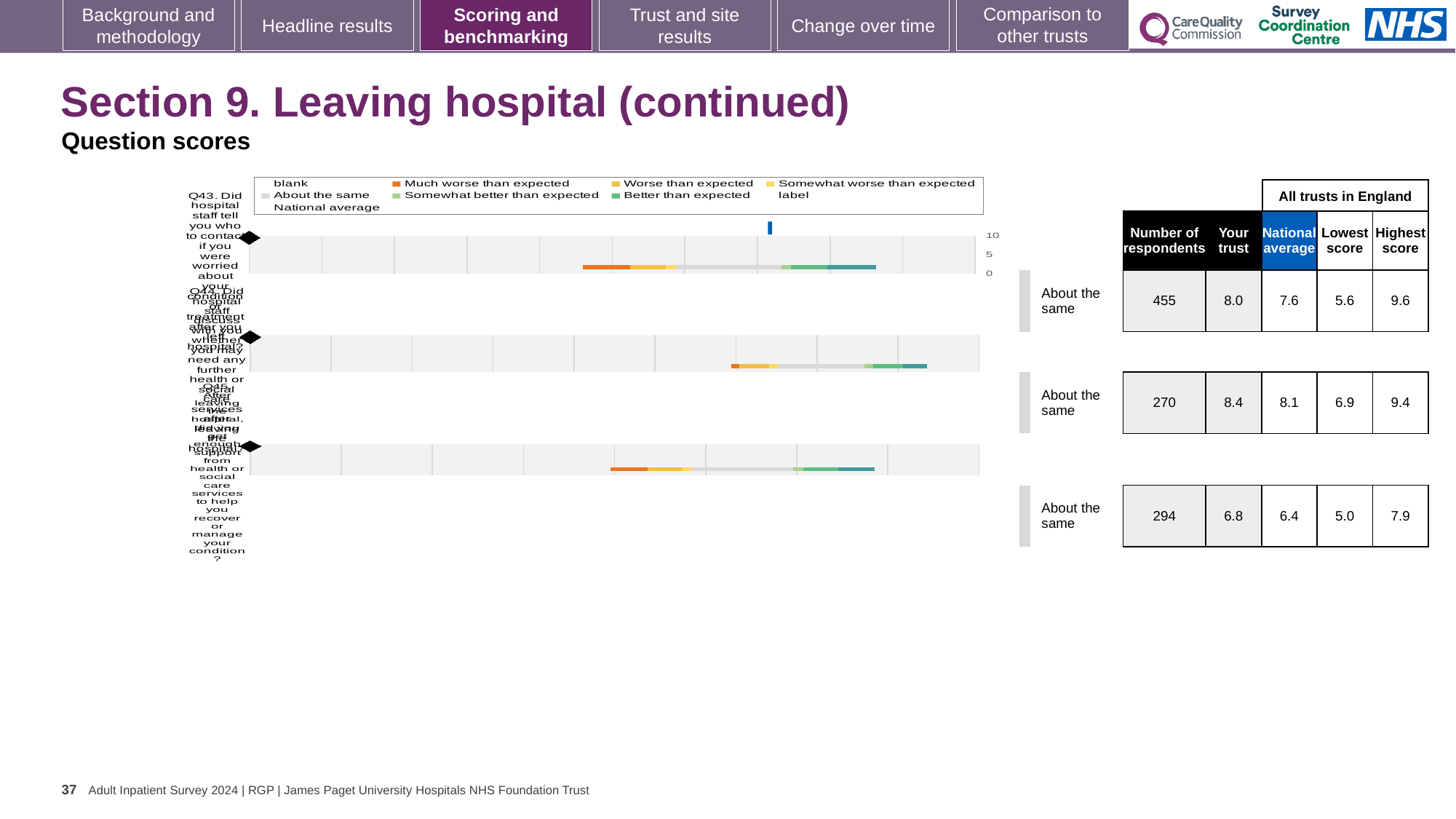
Which of the three charts has the lowest 'Lowest score' value? the bottom chart (Q45), 5.0 Which of the three charts has the highest 'Your trust' score? the middle chart (Q44), 8.4 For the middle chart (Q44), which is larger: the 'Your trust' score or the national average? Your trust For the top chart (Q43), what is the 'Your trust' score shown in the table? 8.0 What kind of chart is used to show the question scores on this slide? bar chart For the middle chart (Q44), what is the national average score? 8.1 For the top chart (Q43), what is the difference between the 'Your trust' score and the national average? 0.4 For the top chart (Q43), what is the highest score among all trusts in England? 9.6 How many question charts are shown on the slide? 3 What benchmark category is shown next to each of the three charts? About the same For the bottom chart (Q45), how many respondents are listed? 294 For the bottom chart (Q45), what is the difference between the highest score and the lowest score? 2.9